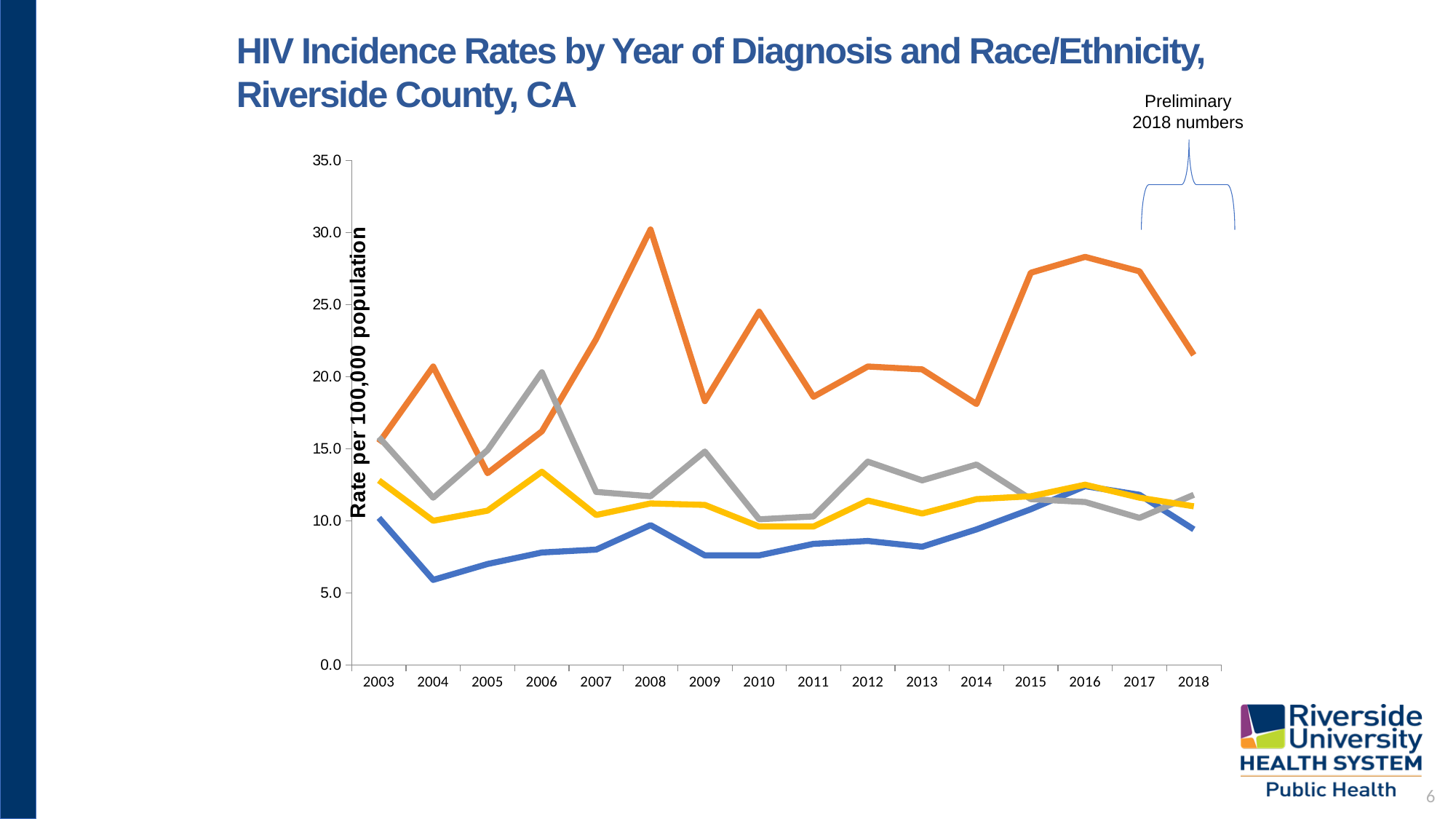
How many lines are plotted on the chart? 4 What kind of chart is shown on the slide? line chart In which year does the gray line reach its highest value? 2006 Is the value of the blue line in 2004 greater or less than 10.0? less In which year does the blue line reach its lowest value? 2004 Is the value of the gray line in 2006 greater or less than 15.0? greater In which year does the orange line reach its highest value? 2008 In 2006, which line has the larger value, the gray line or the yellow line? gray line Does the orange line rise or fall from 2016 to 2018? fall How many years are shown along the x axis of the chart? 16 Is the value of the orange line in 2008 greater or less than 25.0? greater What is the title of the y axis? Rate per 100,000 population